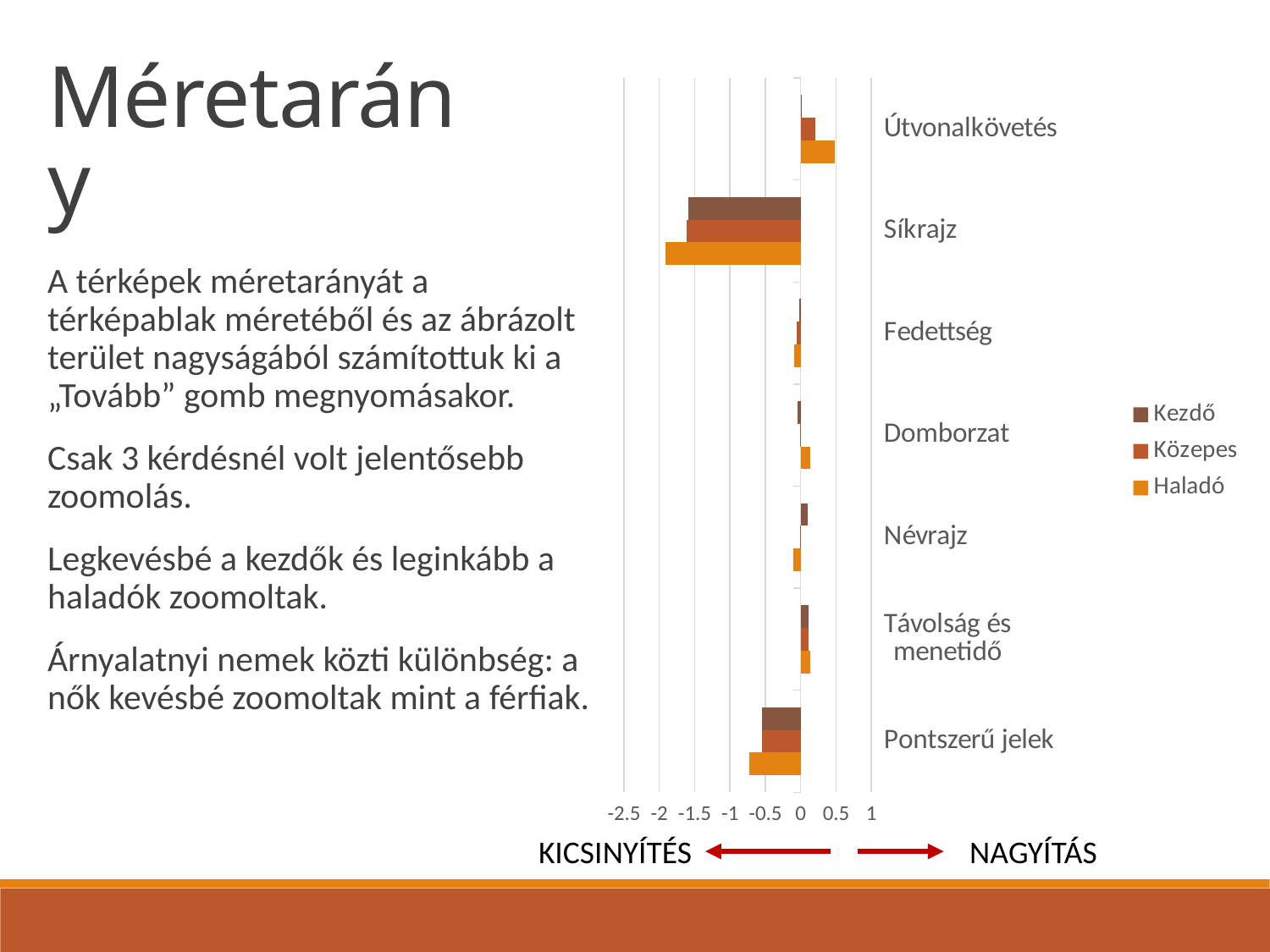
Which category has the most negative (lowest) values on the chart? Síkrajz Is the Haladó value for Útvonalkövetés greater or less than 0? greater How many categories are plotted on the chart? 7 How many series does the chart legend list? 3 For Pontszerű jelek, which series has the longer bar, Kezdő or Haladó? Haladó Is the Haladó value for Pontszerű jelek greater or less than -0.5? less Is the Kezdő value for Síkrajz greater or less than -1? less For Síkrajz, which series has the longer bar, Kezdő or Haladó? Haladó Which series are listed in the chart legend? Kezdő, Közepes, Haladó What kind of chart is shown on the slide? bar chart What labels appear at the two ends of the horizontal axis below the chart? KICSINYÍTÉS and NAGYÍTÁS